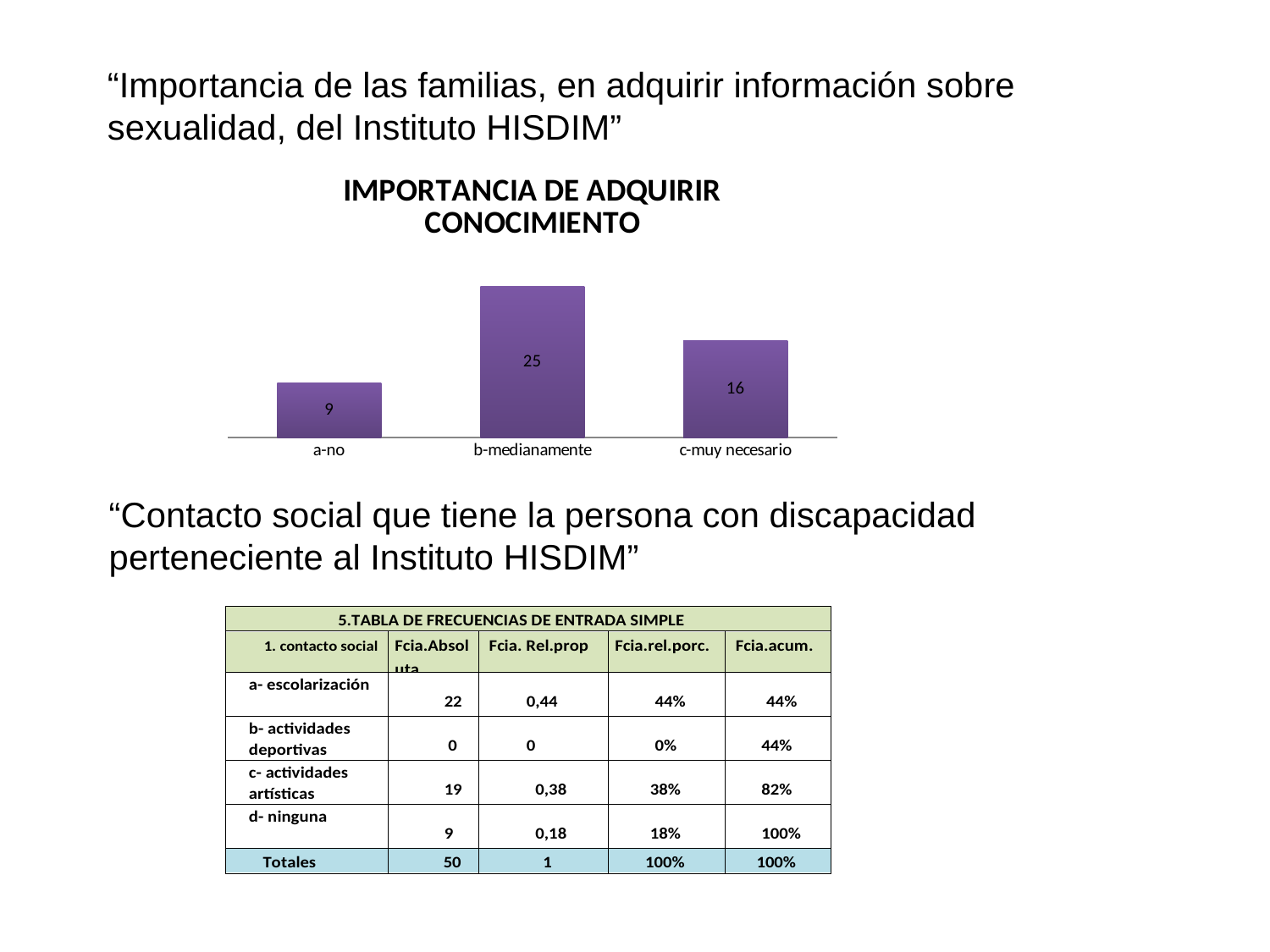
What kind of chart is shown on the slide? bar chart Which category has the lowest value in the chart? a-no How many categories are shown in the chart? 3 What is the difference between the values for b-medianamente and c-muy necesario? 9 What is the value for c-muy necesario in the chart? 16 What is the total of the three values shown in the chart? 50 What is the difference between the values for c-muy necesario and a-no? 7 What is the title of the chart? IMPORTANCIA DE ADQUIRIR CONOCIMIENTO What is the value for b-medianamente in the chart? 25 What is the value for a-no in the chart? 9 Which is larger, the value for c-muy necesario or the value for a-no? c-muy necesario Which category has the highest value in the chart? b-medianamente